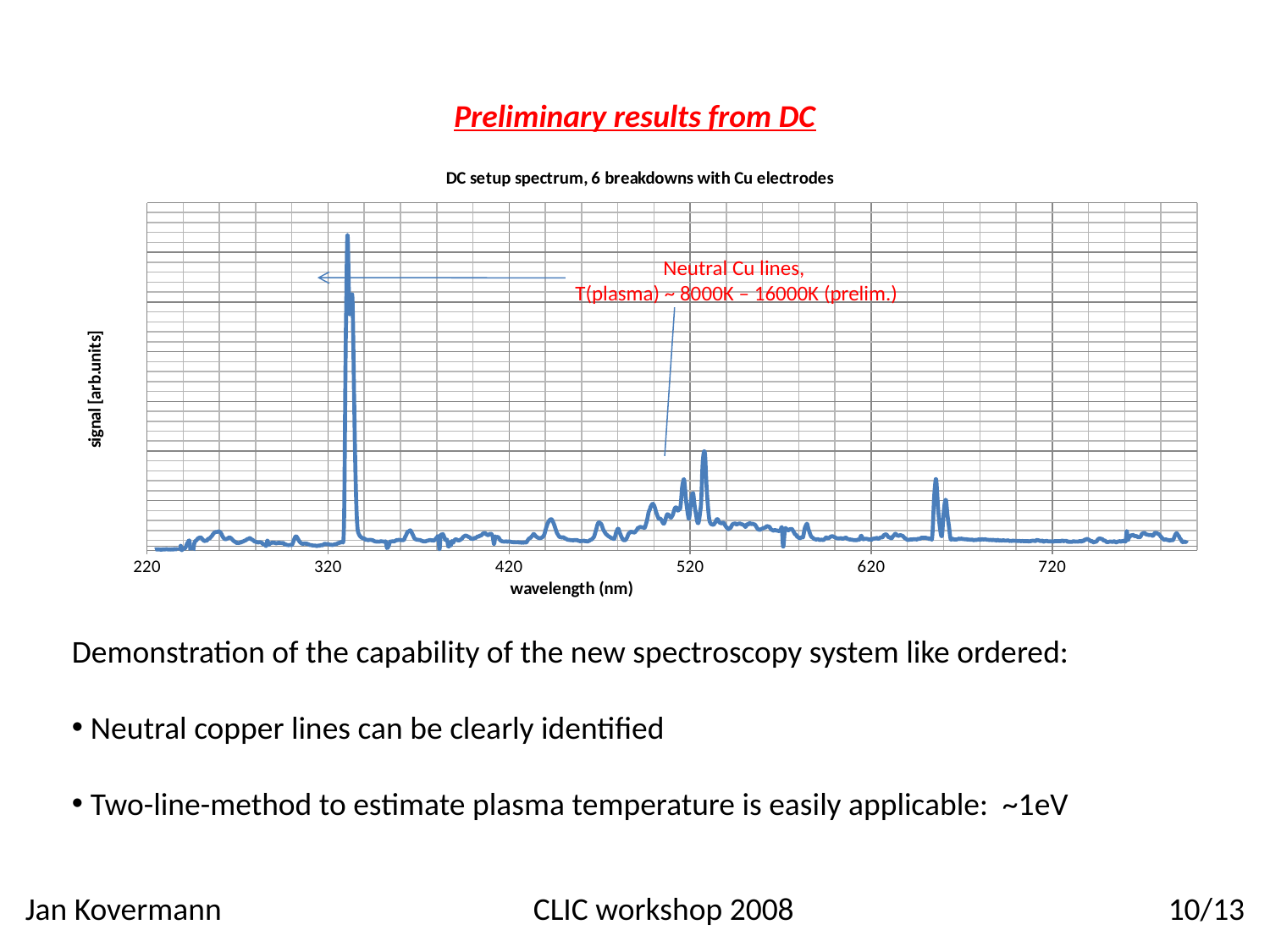
What is the highest labelled value on the x axis? 720 What is the title of the chart? DC setup spectrum, 6 breakdowns with Cu electrodes What is the label of the x axis of the chart? wavelength (nm) Is the wavelength of the pair of peaks located between the 620 and 720 ticks greater or less than 620? greater How many labelled tick values are shown on the x axis? 6 Is the wavelength of the tallest peak greater or less than 320? greater Which is taller: the peak just above 320 nm or the peak between 620 and 720 nm? the peak just above 320 nm Between which two labelled x-axis ticks does the tallest peak of the spectrum occur? 320 and 420 Is the wavelength of the tallest peak greater or less than 420? less Which is taller: the cluster of peaks around 520 nm or the pair of peaks between 620 and 720 nm? the cluster around 520 nm What kind of chart is shown on the slide? line chart What is the lowest labelled value on the x axis? 220